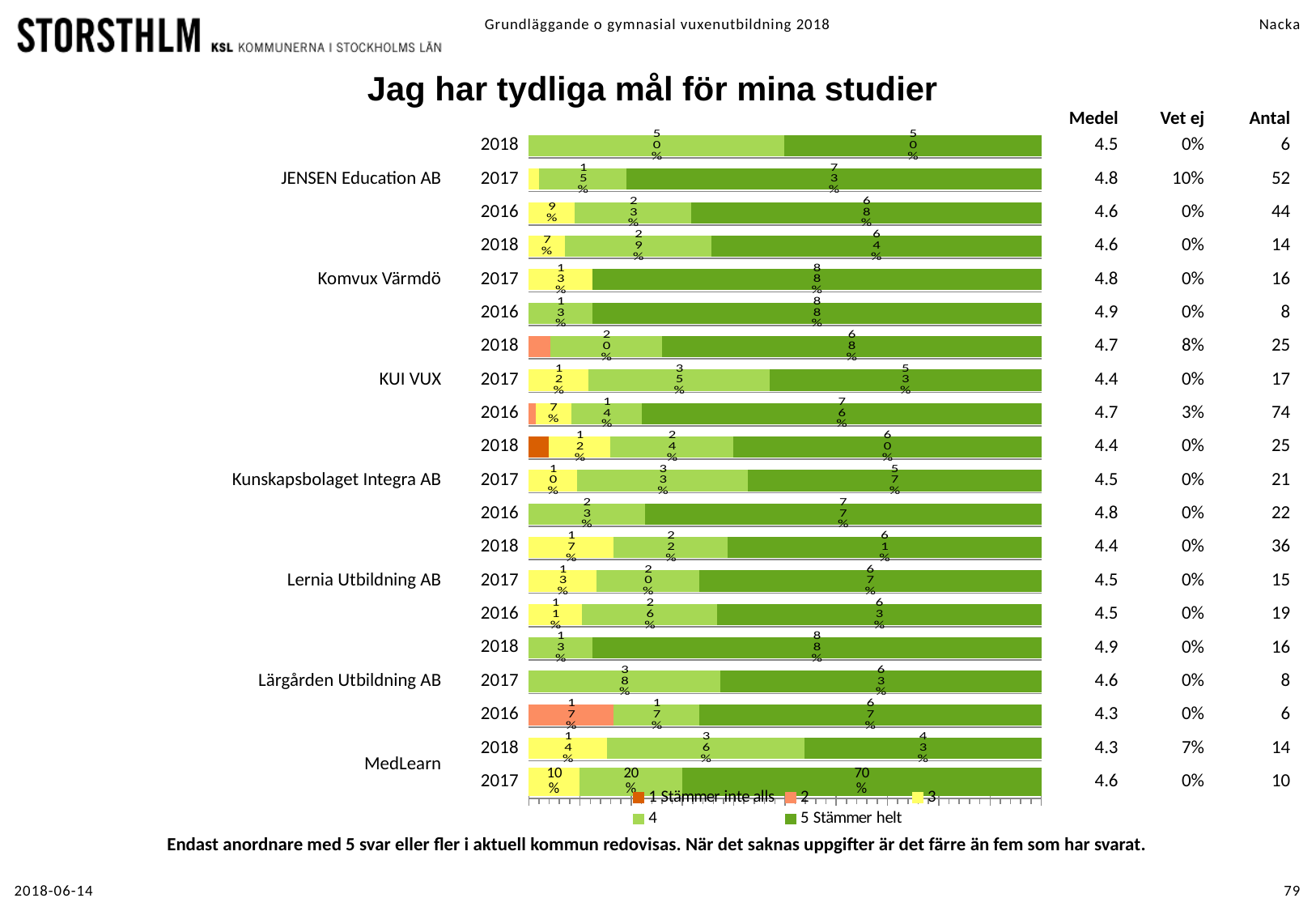
How many series does the legend list? 5 What percentage of MedLearn 2017 respondents answered '5 Stämmer helt'? 70% What is the difference between the '5 Stämmer helt' share for Kunskapsbolaget Integra AB 2016 and 2018? 17% Which has a larger '4' share: Lärgården Utbildning AB 2017 or KUI VUX 2017? Lärgården Utbildning AB 2017 What percentage of JENSEN Education AB 2018 respondents answered '4'? 50% What percentage of Komvux Värmdö 2018 respondents answered '5 Stämmer helt'? 64% What is the label of the darkest green series in the legend? 5 Stämmer helt What percentage of Lärgården Utbildning AB 2016 respondents answered '2'? 17% What type of chart is shown on the slide? stacked bar chart Which bar has the lowest share of '5 Stämmer helt' responses? MedLearn 2018 What percentage of Lernia Utbildning AB 2018 respondents answered '3'? 17% What is the title of the chart? Jag har tydliga mål för mina studier